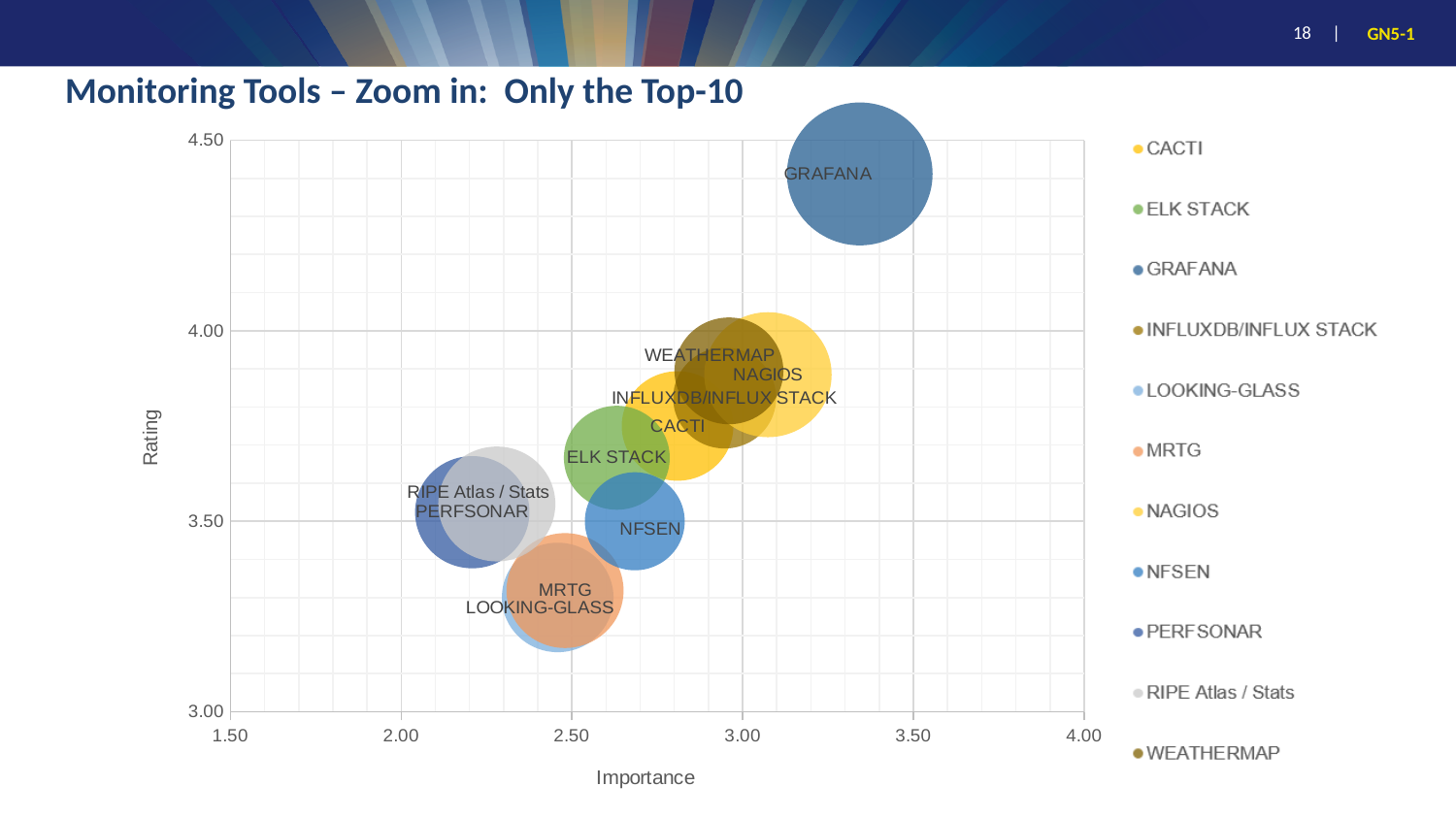
How many series does the legend list? 11 Is the Rating for GRAFANA greater or less than 4.00? greater Which has the higher Rating, ELK STACK or NFSEN? ELK STACK Which tool has the highest Importance? GRAFANA What is the label of the vertical axis? Rating Is the Importance for PERFSONAR greater or less than 2.50? less What kind of chart is shown on the slide? Bubble chart Which has the higher Importance, NAGIOS or PERFSONAR? NAGIOS Which tool has the highest Rating? GRAFANA Is the Rating for ELK STACK greater or less than 3.50? greater What is the title of the chart on the slide? Monitoring Tools – Zoom in: Only the Top-10